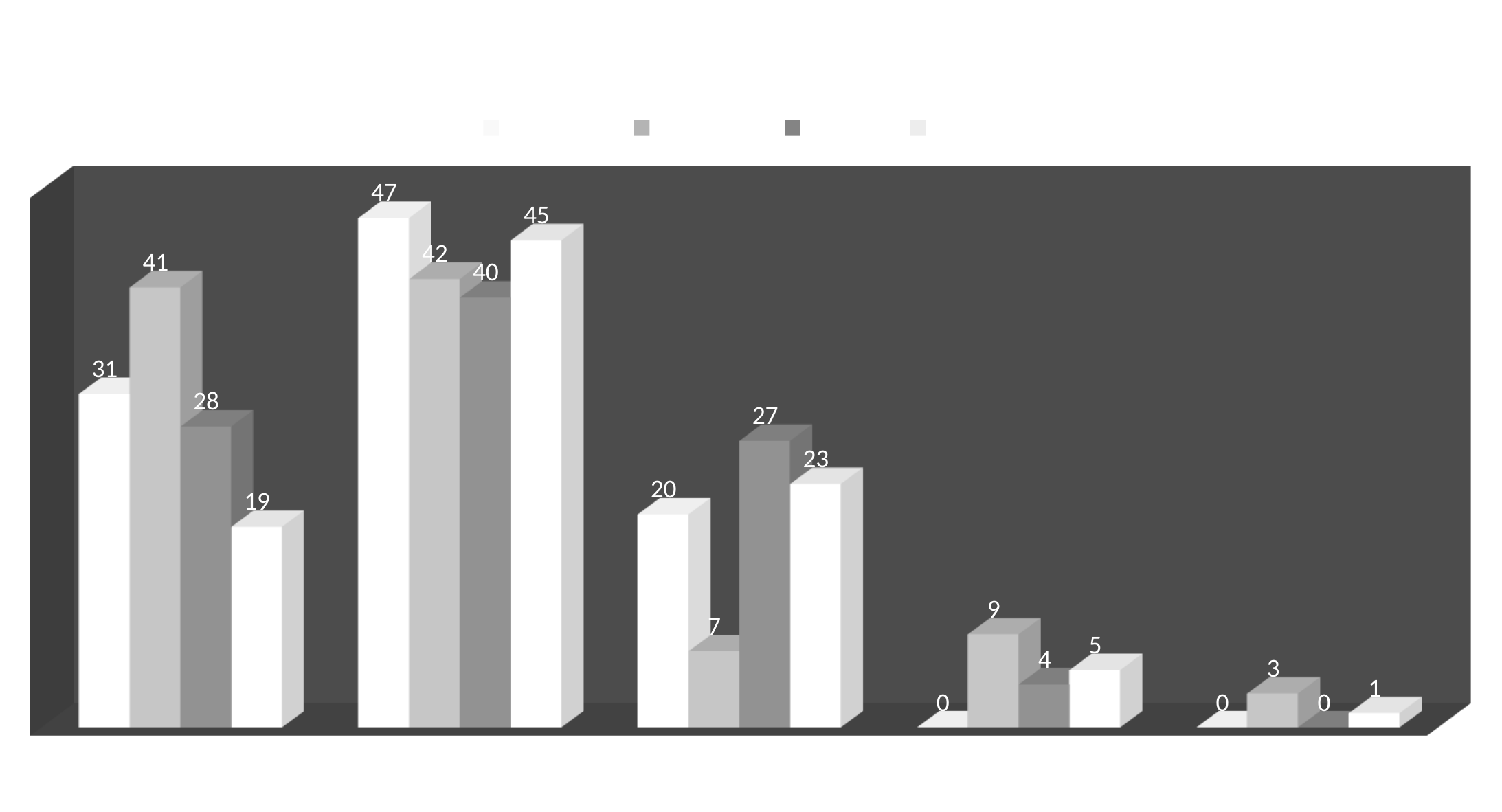
How many groups of bars (categories) are plotted along the x axis? 5 What is the value of the tallest bar in the first (leftmost) group? 41 What is the difference between the second bar (41) and the first bar (31) in the first group? 10 What is the value of the third bar in the third group from the left? 27 In the third group from the left, which is larger: the first bar or the fourth bar? the fourth bar (23) What is the lowest value among the four bars in the second group from the left? 40 What kind of chart is shown on the slide? bar chart How many bars in the rightmost group are labelled 0? 2 What is the value of the second bar in the fourth group from the left? 9 What is the difference between the first bar (47) and the fourth bar (45) in the second group? 2 How many series does the legend show? 4 What is the highest value labelled on any bar in the chart? 47